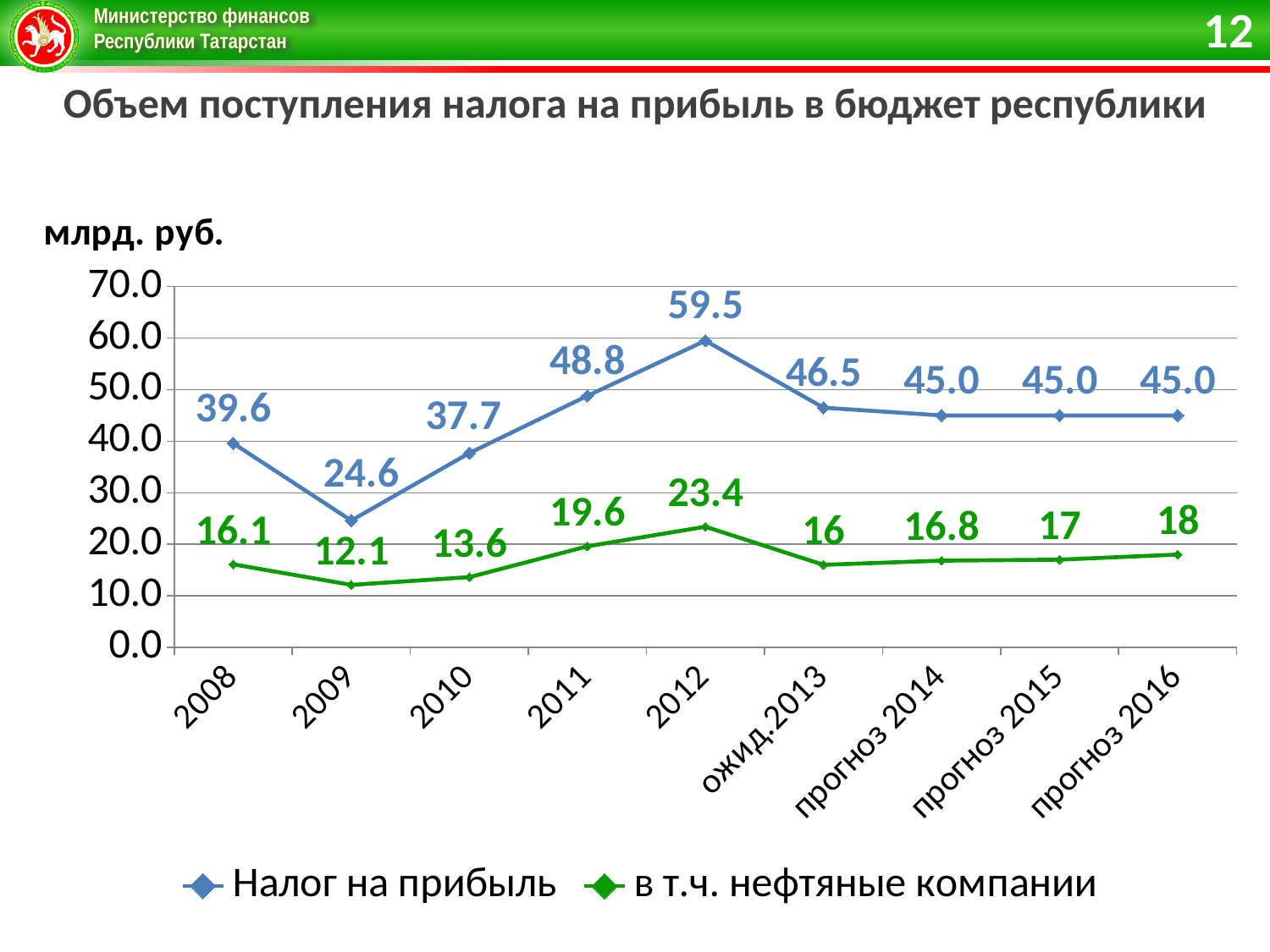
How many series does the legend list? 2 Is the value of "Налог на прибыль" for "ожид.2013" greater or less than 40.0? greater How many categories are shown on the x axis? 9 What is the value of "в т.ч. нефтяные компании" in 2009? 12.1 What is the value of "Налог на прибыль" for "прогноз 2015"? 45.0 In which year is "в т.ч. нефтяные компании" at its lowest? 2009 Which is larger: "Налог на прибыль" in 2008 or in 2010? 2008 What unit is indicated above the chart? млрд. руб. What is the difference between "Налог на прибыль" and "в т.ч. нефтяные компании" in 2011? 29.2 What is the value of "Налог на прибыль" in 2012? 59.5 In which year does "Налог на прибыль" reach its highest value? 2012 What kind of chart is shown on the slide? line chart